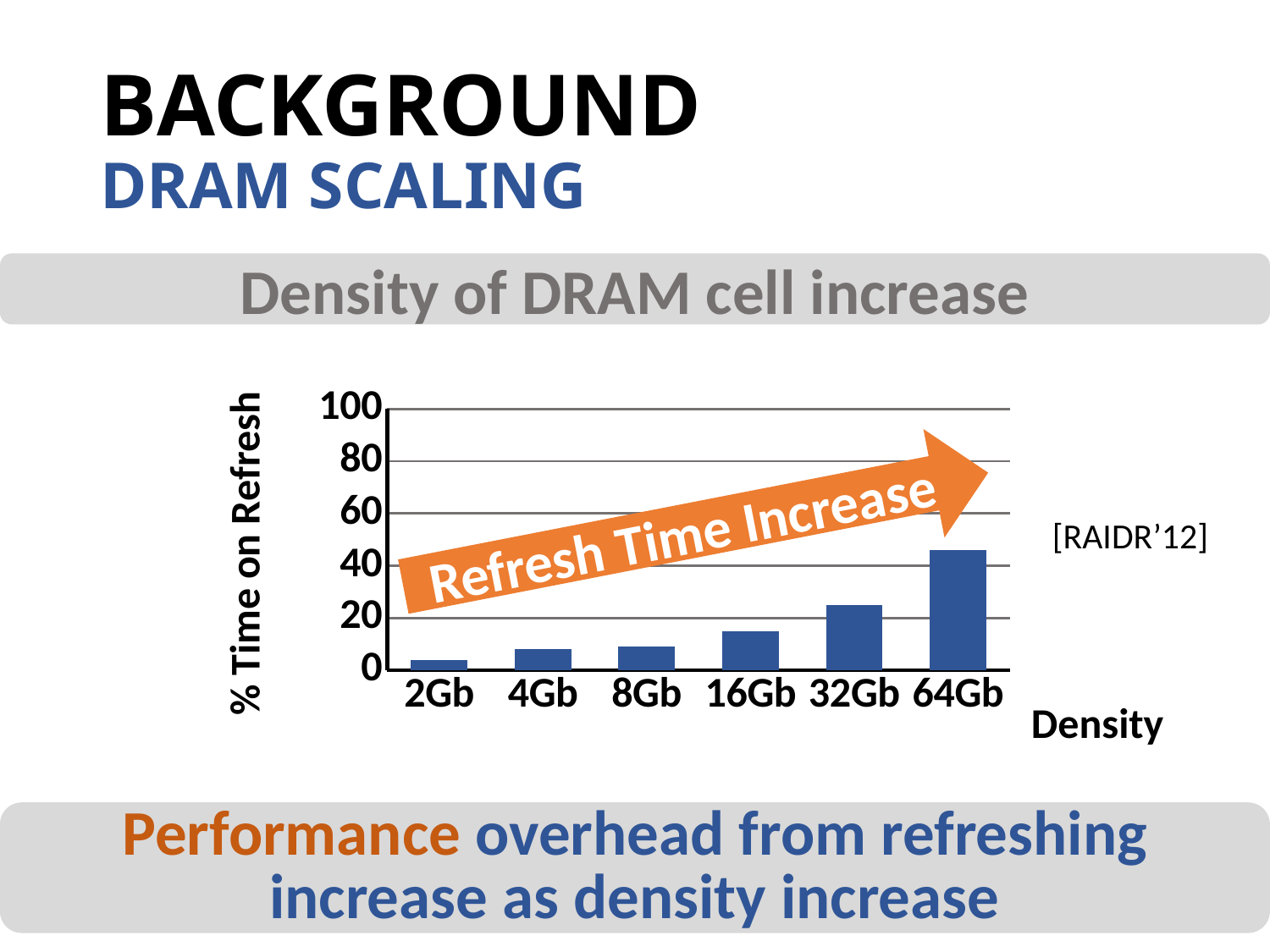
Which has a larger % time on refresh, 32Gb or 64Gb? 64Gb Which has a larger % time on refresh, 2Gb or 16Gb? 16Gb What is the label of the y axis? % Time on Refresh Which density has the highest % time on refresh? 64Gb What text is written on the orange arrow over the chart? Refresh Time Increase Which density has the lowest % time on refresh? 2Gb How many density categories are plotted on the x axis? 6 Is the value for 64Gb greater or less than 40? greater Is the value for 32Gb greater or less than 20? greater What kind of chart is shown on the slide? bar chart Do the values rise or fall as density increases along the x axis? rise Is the value for 16Gb greater or less than 20? less